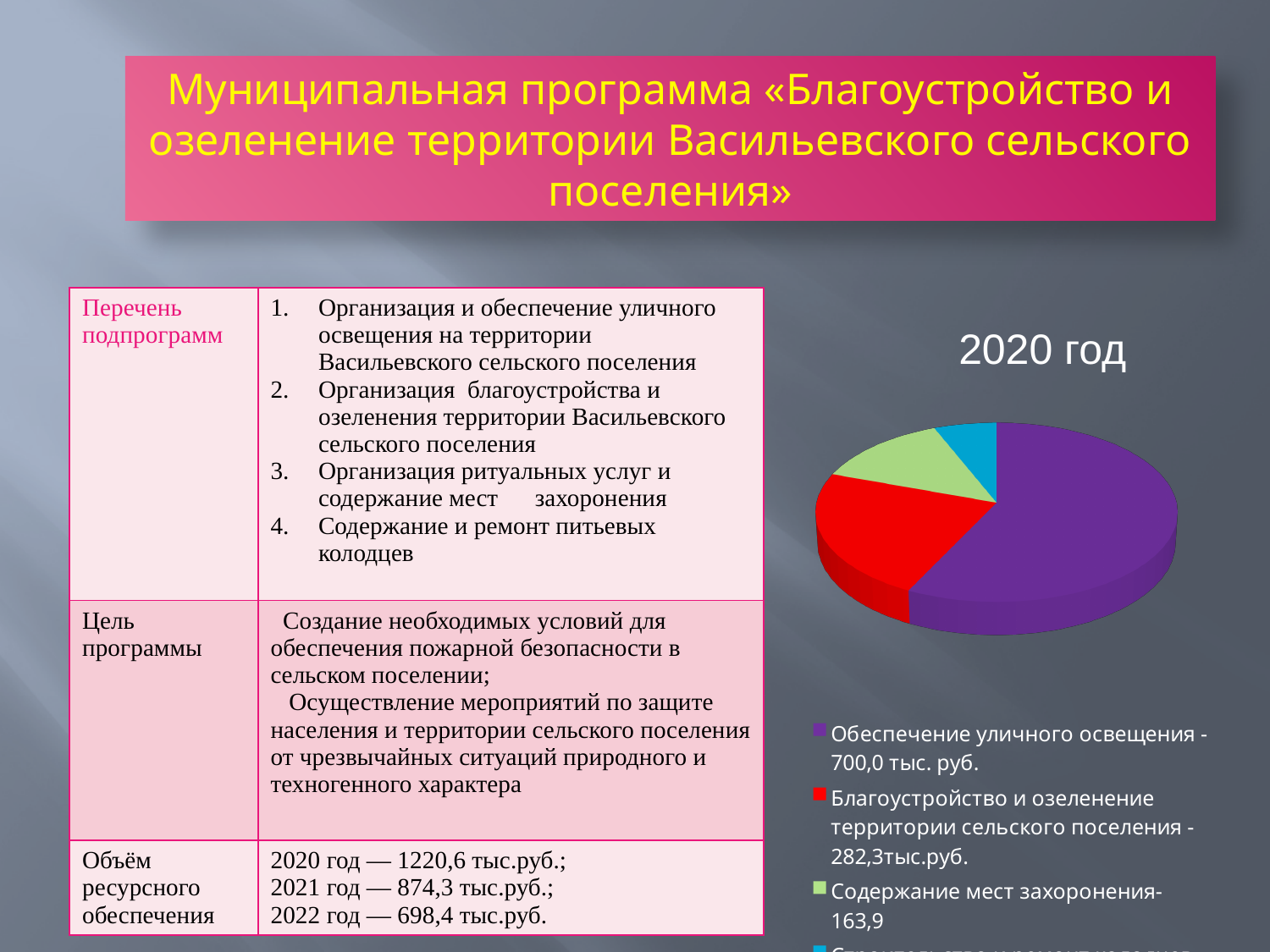
How many slices does the pie chart have? 4 What is the difference between the values for Благоустройство и озеленение территории сельского поселения and Содержание мест захоронения? 118,4 Which is larger: Благоустройство и озеленение территории сельского поселения or Содержание мест захоронения? Благоустройство и озеленение территории сельского поселения What kind of chart is shown on the slide? pie chart Which is larger: Обеспечение уличного освещения or Благоустройство и озеленение территории сельского поселения? Обеспечение уличного освещения According to the legend, what is the value for Благоустройство и озеленение территории сельского поселения? 282,3 тыс.руб. According to the legend, what is the value for Обеспечение уличного освещения? 700,0 тыс. руб. What is the title of the pie chart? 2020 год According to the legend, what is the value for Содержание мест захоронения? 163,9 Which category has the largest slice in the pie chart? Обеспечение уличного освещения What is the difference between the values for Обеспечение уличного освещения and Благоустройство и озеленение территории сельского поселения? 417,7 тыс. руб. What colour is the slice for Обеспечение уличного освещения? purple